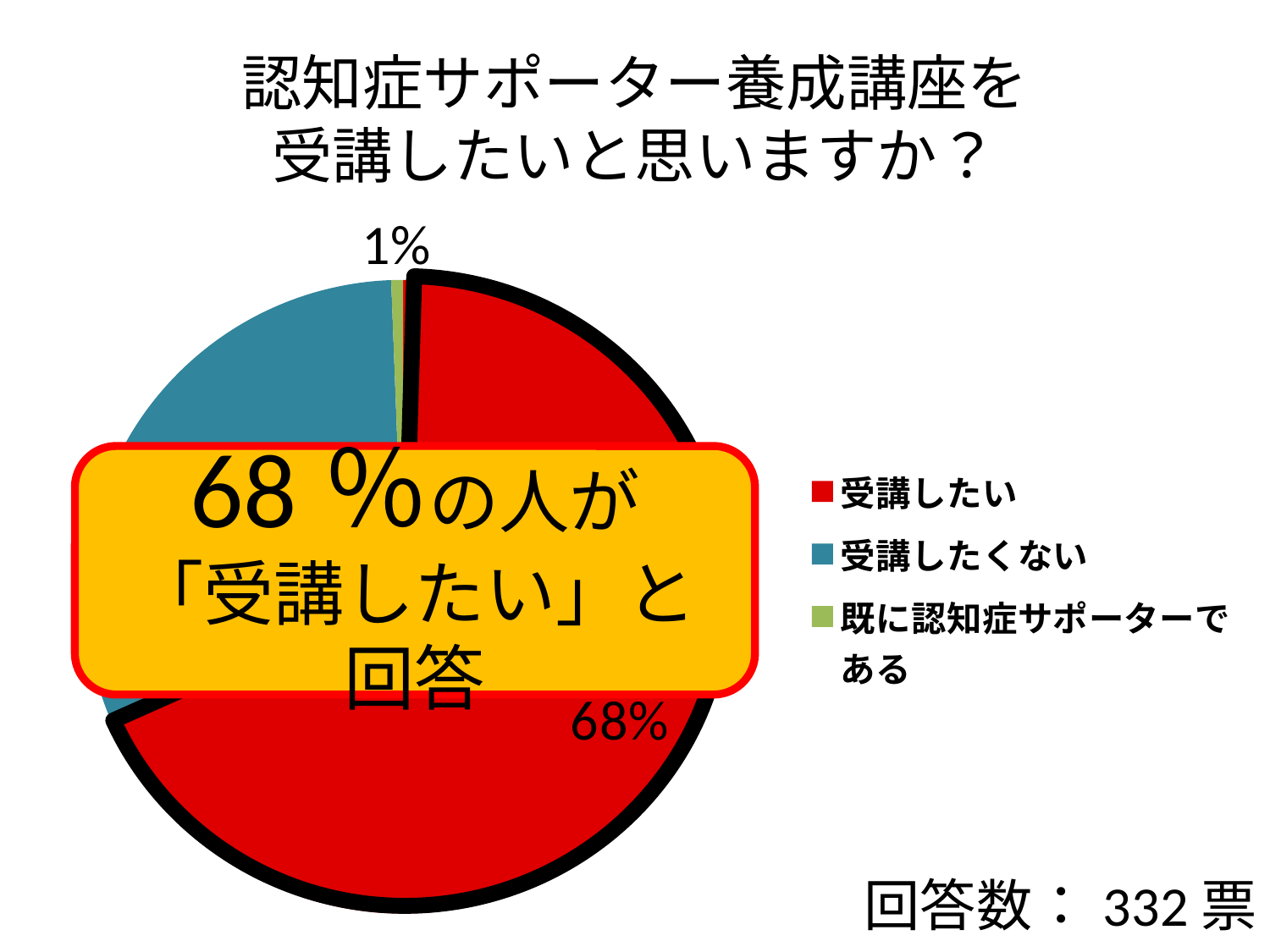
What is the title of the chart on the slide? 認知症サポーター養成講座を受講したいと思いますか？ Which response category has the smallest share of the pie? 既に認知症サポーターである Which response category has the largest share of the pie? 受講したい How many entries does the legend list? 3 How many response categories does the pie chart show? 3 What percentage of respondents answered 受講したい? 68% What is the difference in percentage points between the 受講したい slice and the 既に認知症サポーターである slice? 67% What percentage of respondents answered 既に認知症サポーターである? 1% Which is larger: the share for 受講したい or the share for 受講したくない? 受講したい What kind of chart is shown on the slide? Pie chart Which colour represents 受講したくない in the legend? Blue What share of the pie does the 受講したい slice represent? 68%